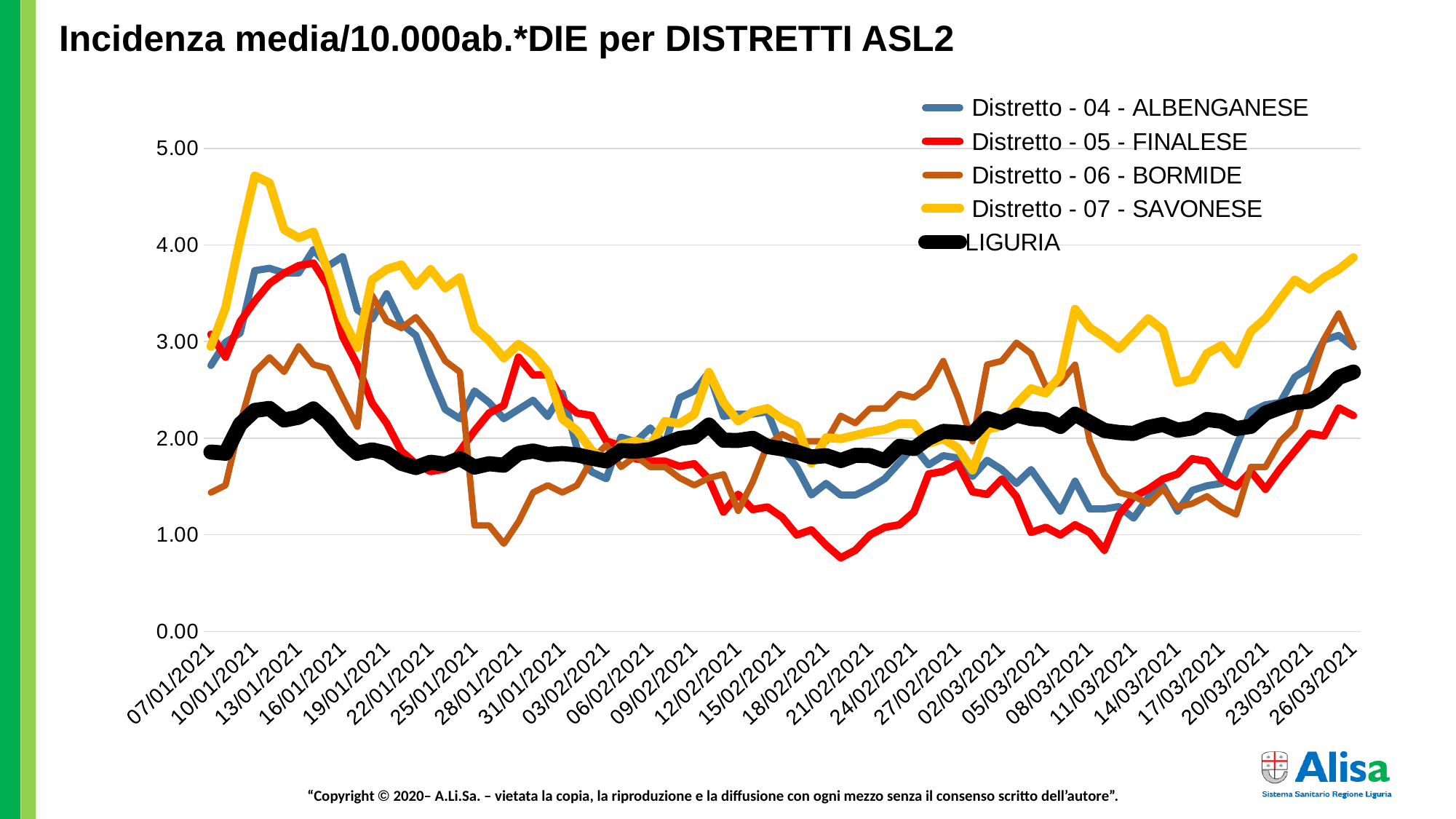
Which series is drawn as the thick black line? LIGURIA Is the value for LIGURIA on 26/03/2021 greater or less than 2.00? greater Is the value for Distretto - 07 - SAVONESE on 26/03/2021 greater or less than 3.00? greater Which series has the highest value on 26/03/2021? Distretto - 07 - SAVONESE What kind of chart is shown on the slide? line chart Which series has the lowest value on 21/02/2021? Distretto - 05 - FINALESE How many series does the legend list? 5 Does the Distretto - 07 - SAVONESE line rise or fall between 10/01/2021 and 06/02/2021? fall Is the peak value of Distretto - 07 - SAVONESE around 10/01/2021 greater or less than 4.00? greater On 26/03/2021, which is larger: Distretto - 07 - SAVONESE or Distretto - 05 - FINALESE? Distretto - 07 - SAVONESE What is the title of the chart? Incidenza media/10.000ab.*DIE per DISTRETTI ASL2